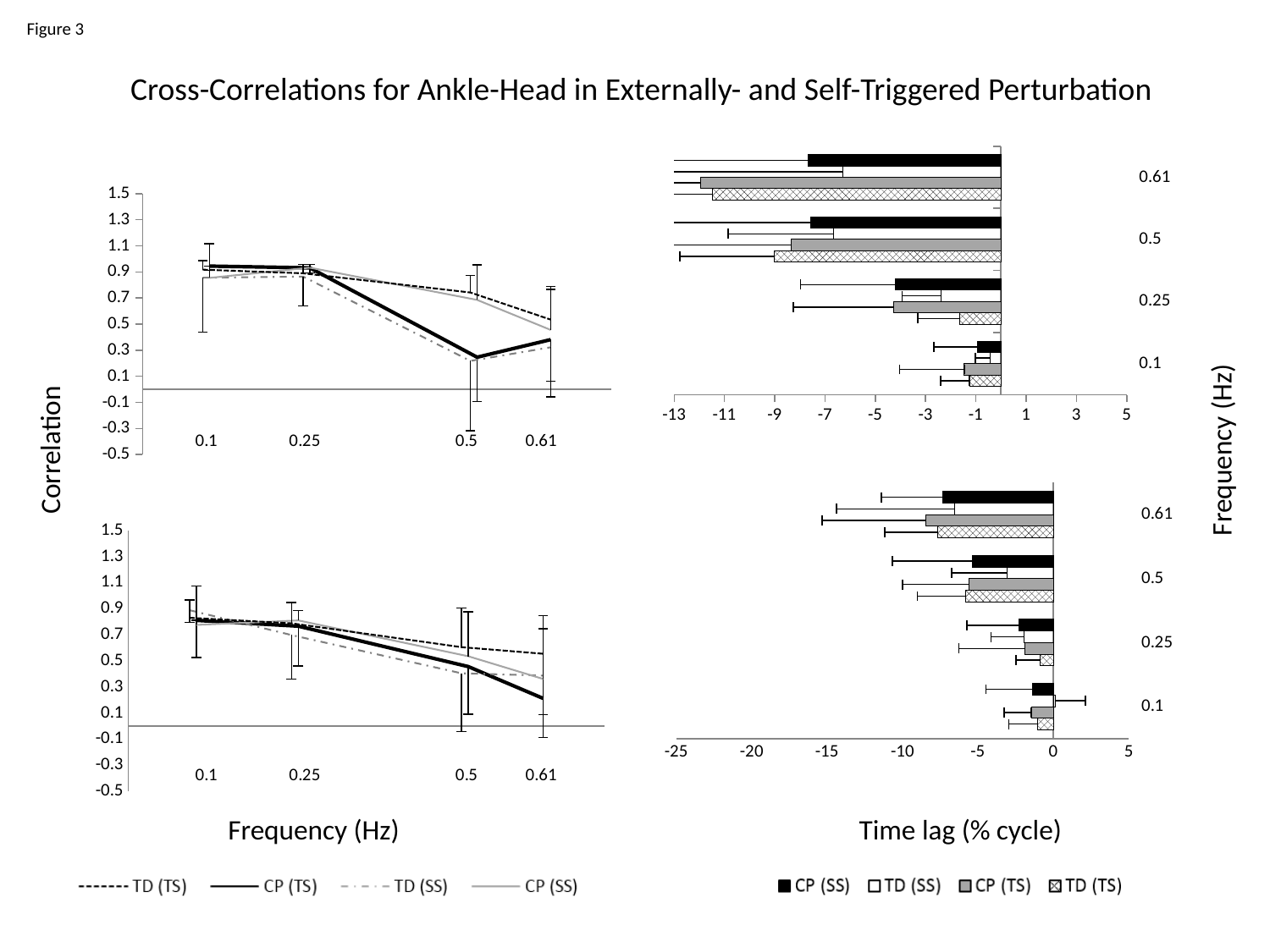
How many series does the legend of the right-hand bar charts list? 4 In the top-left line chart, is the CP (TS) value at 0.5 Hz greater or less than 0.5? less What kind of chart is the top-left chart on the slide? line chart In the bottom-right bar chart, how many frequency categories are shown on the vertical axis? 4 In the top-left line chart, do the CP (TS) values rise or fall from 0.1 Hz to 0.5 Hz? fall How many series does the legend of the left-hand line charts list? 4 In the top-left line chart, is the CP (TS) value at 0.1 Hz greater or less than 0.7? greater In the top-left line chart, how many frequency points are plotted along the x axis? 4 What is the title of the figure on the slide? Cross-Correlations for Ankle-Head in Externally- and Self-Triggered Perturbation What is the x-axis label of the right-hand bar charts? Time lag (% cycle) In the bottom-left line chart, is the CP (TS) value at 0.61 Hz greater or less than 0.5? less What kind of chart is the top-right chart on the slide? bar chart